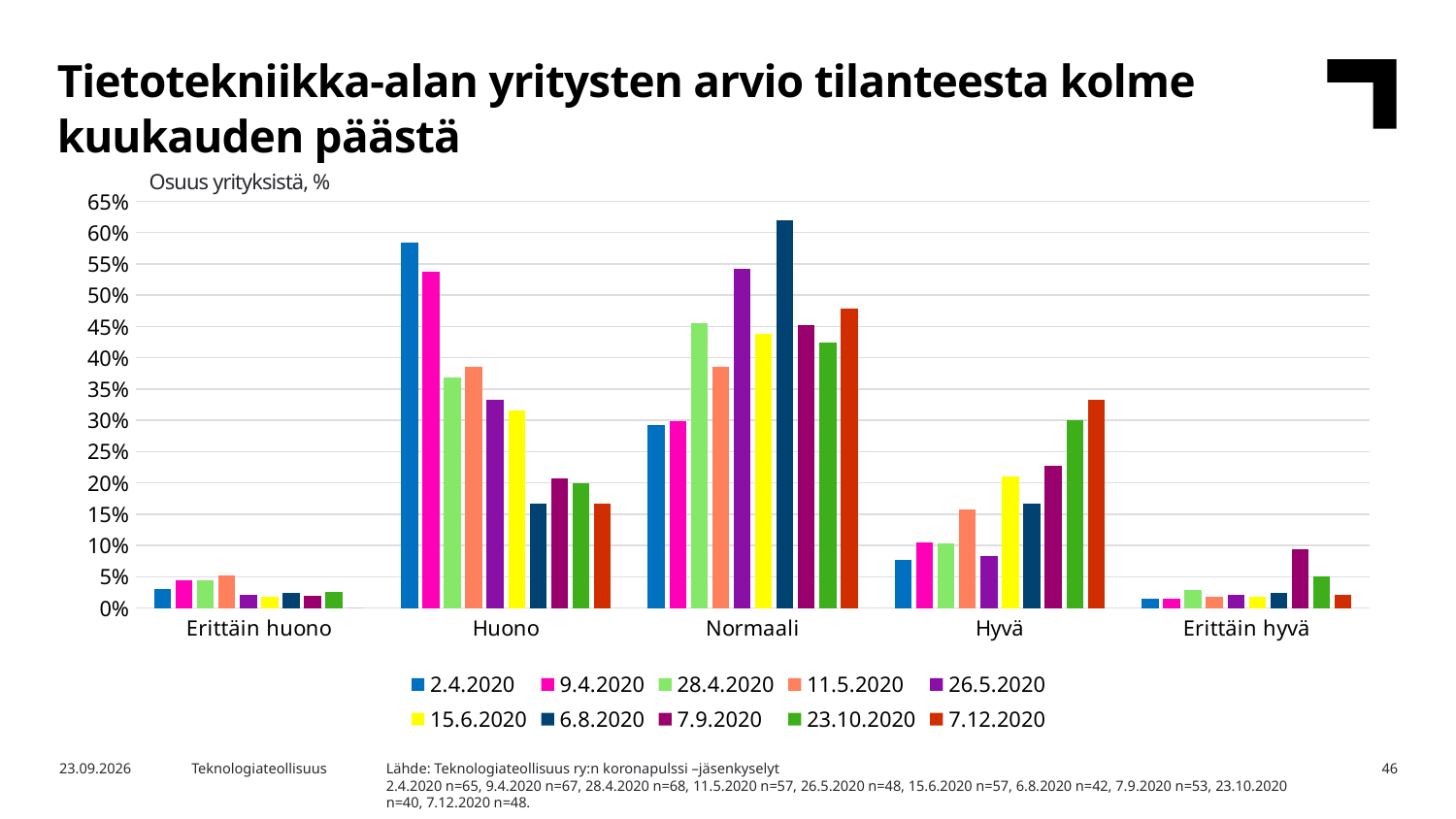
What kind of chart is shown on the slide? Bar chart How many response categories are shown on the x axis? 5 Which survey date has the highest bar in the Erittäin hyvä category? 7.9.2020 What is the label shown above the y axis of the chart? Osuus yrityksistä, % Is the value for 2.4.2020 in the Huono category greater or less than 55%? greater Which survey date has the highest bar in the Hyvä category? 7.12.2020 Is the value for 6.8.2020 in the Huono category greater or less than 20%? less Is the value for 6.8.2020 in the Normaali category greater or less than 60%? greater In the Normaali category, which is larger: the value for 6.8.2020 or the value for 26.5.2020? 6.8.2020 Which survey date has the highest bar in the Normaali category? 6.8.2020 How many series (survey dates) does the legend list? 10